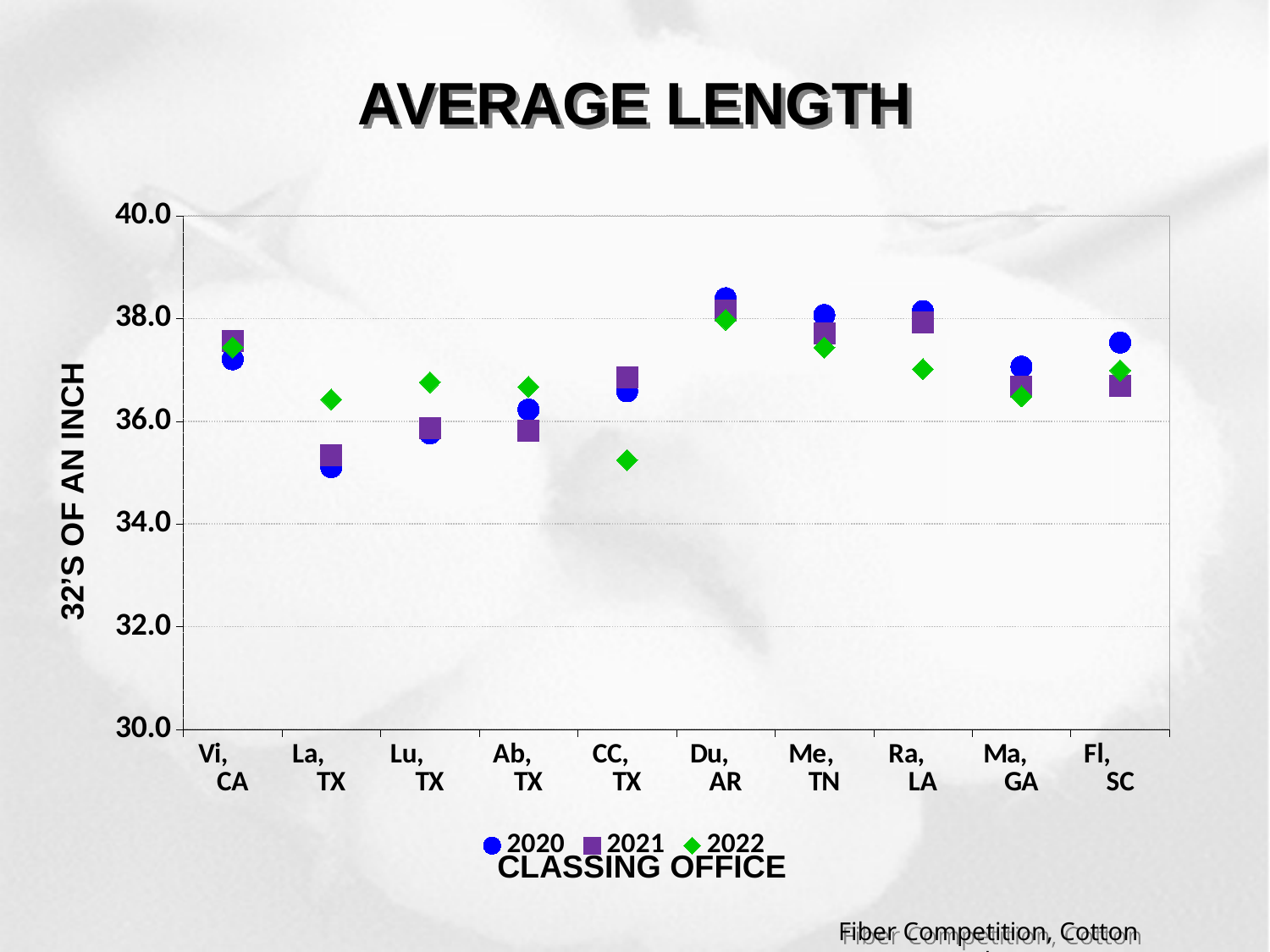
How many classing offices are shown on the x axis? 10 Which classing office has the lowest 2020 value? La, TX Is the 2020 value for Du, AR greater or less than 38.0? greater Is the 2020 value for La, TX greater or less than 36.0? less Which classing office has the lowest 2022 value? CC, TX How many series does the legend list? 3 What is the label of the vertical axis? 32'S OF AN INCH Is the 2022 value for Ra, LA greater or less than 38.0? less What is the title of the chart? AVERAGE LENGTH What kind of chart is this? Scatter chart For CC, TX, which is larger: the 2021 value or the 2022 value? 2021